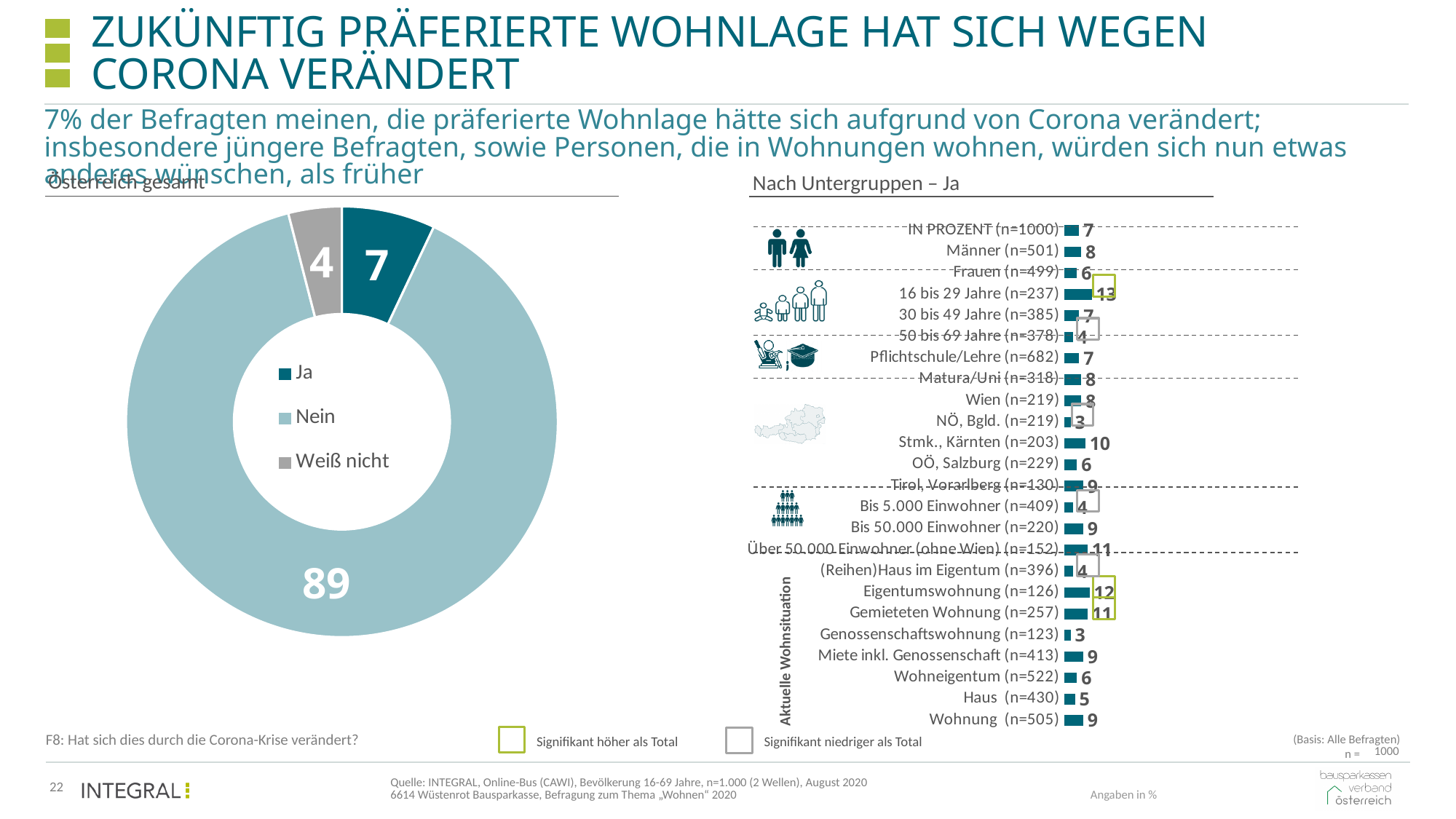
In the 'Österreich gesamt' chart, how many entries does the legend list? 3 In the 'Nach Untergruppen – Ja' chart, what is the value for 'Stmk., Kärnten (n=203)'? 10 In the 'Nach Untergruppen – Ja' chart, what is the value for '16 bis 29 Jahre (n=237)'? 13 In the 'Österreich gesamt' chart, what value is shown for 'Nein'? 89 In the 'Nach Untergruppen – Ja' chart, what is the difference between 'Männer (n=501)' and 'Frauen (n=499)'? 2 What kind of chart is the 'Österreich gesamt' chart? Donut (pie) chart What kind of chart is the 'Nach Untergruppen – Ja' chart? Bar chart In the 'Österreich gesamt' chart, which category has the largest slice? Nein In the 'Österreich gesamt' chart, what value is shown for 'Ja'? 7 In the 'Nach Untergruppen – Ja' chart, how many categories are plotted? 24 In the 'Nach Untergruppen – Ja' chart, which is larger: 'Eigentumswohnung (n=126)' or '(Reihen)Haus im Eigentum (n=396)'? Eigentumswohnung (n=126) In the 'Nach Untergruppen – Ja' chart, which category has the highest value? 16 bis 29 Jahre (n=237)